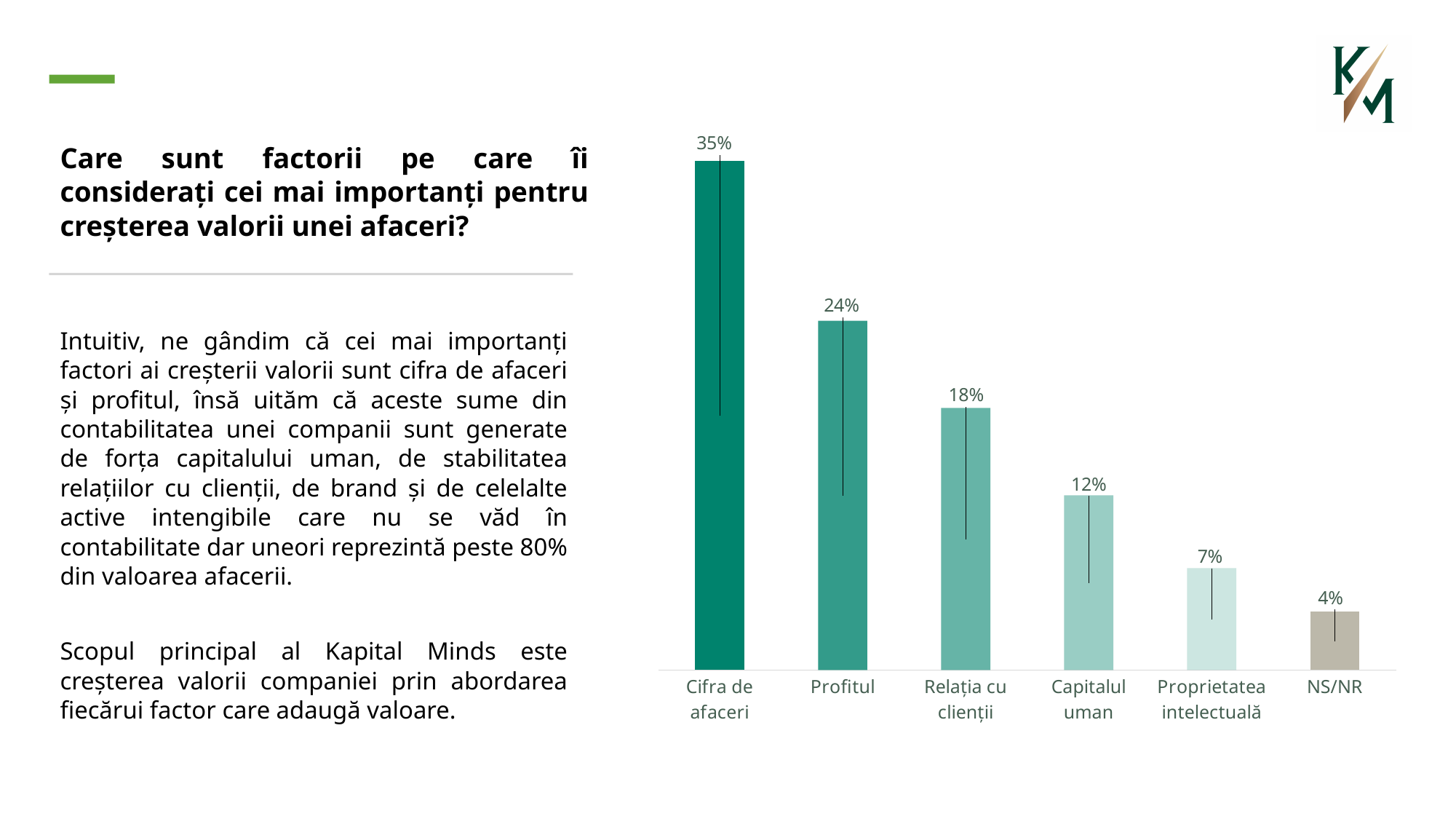
What kind of chart is shown on the slide? Bar chart How many categories are shown in the chart? 6 What is the value for Capitalul uman? 12% What is the value for Proprietatea intelectuală? 7% What is the difference between the values for Cifra de afaceri and Profitul? 11% What is the value for Profitul? 24% What is the value for Cifra de afaceri? 35% What is the value for Relația cu clienții? 18% Which is larger, the value for Relația cu clienții or the value for Capitalul uman? Relația cu clienții Which category has the highest value? Cifra de afaceri What is the value for NS/NR? 4% Which category has the lowest value? NS/NR